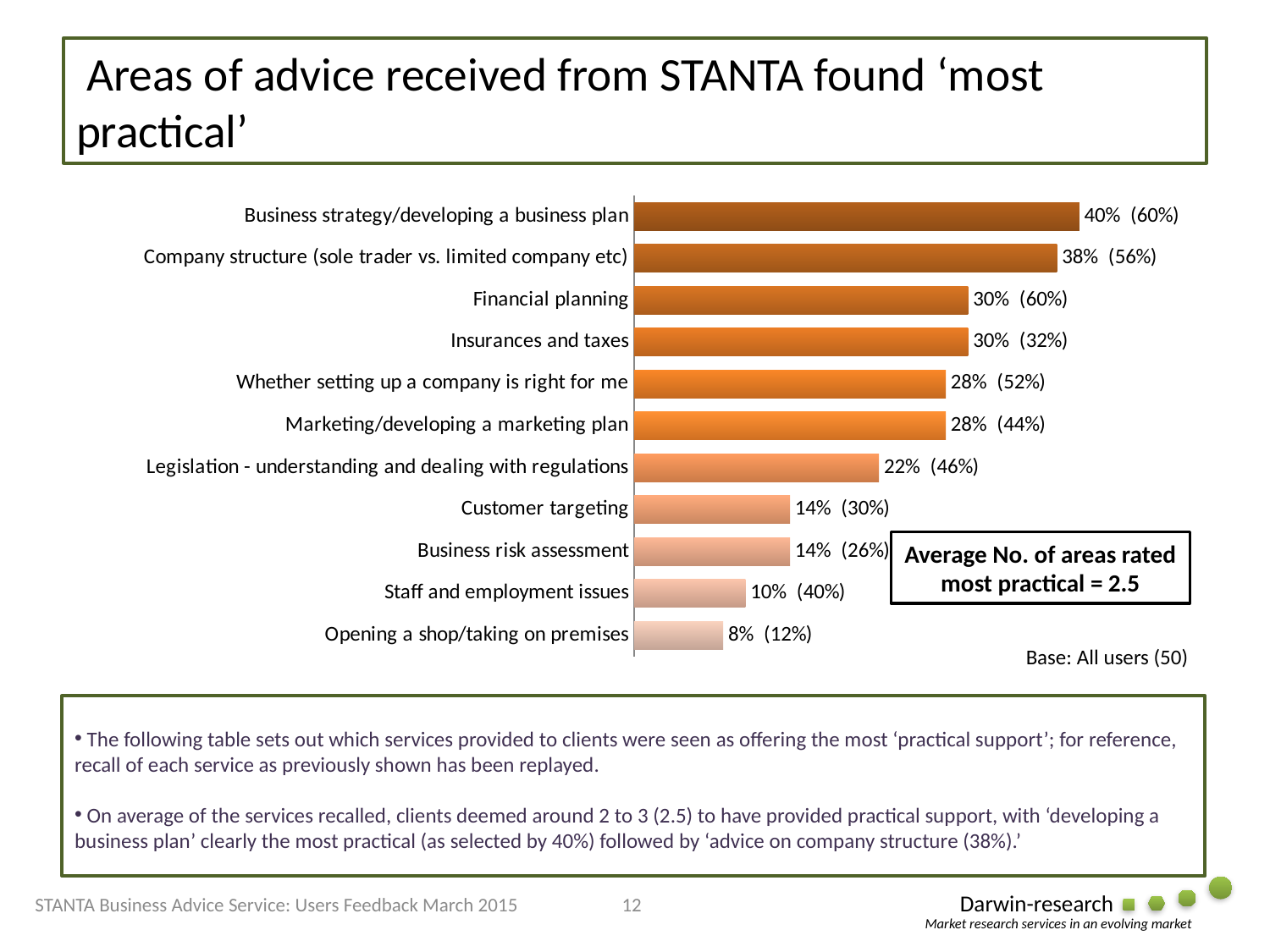
What is the difference in percentage points between 'Company structure (sole trader vs. limited company etc)' and 'Customer targeting' for being rated most practical? 24 How many areas of advice are shown in the chart? 11 What percentage of users rated 'Staff and employment issues' as most practical? 10% What percentage of users rated 'Legislation - understanding and dealing with regulations' as most practical? 22% What type of chart is used on this slide? Bar chart Which area of advice has the lowest percentage rated most practical? Opening a shop/taking on premises Which has a higher percentage rated most practical: 'Financial planning' or 'Marketing/developing a marketing plan'? Financial planning What percentage of users rated 'Insurances and taxes' as most practical? 30% According to the text box on the chart, what is the average number of areas rated most practical? 2.5 What percentage of users rated 'Business strategy/developing a business plan' as most practical? 40% Which area of advice has the highest percentage rated most practical? Business strategy/developing a business plan What is the base (number of respondents) for the chart? All users (50)